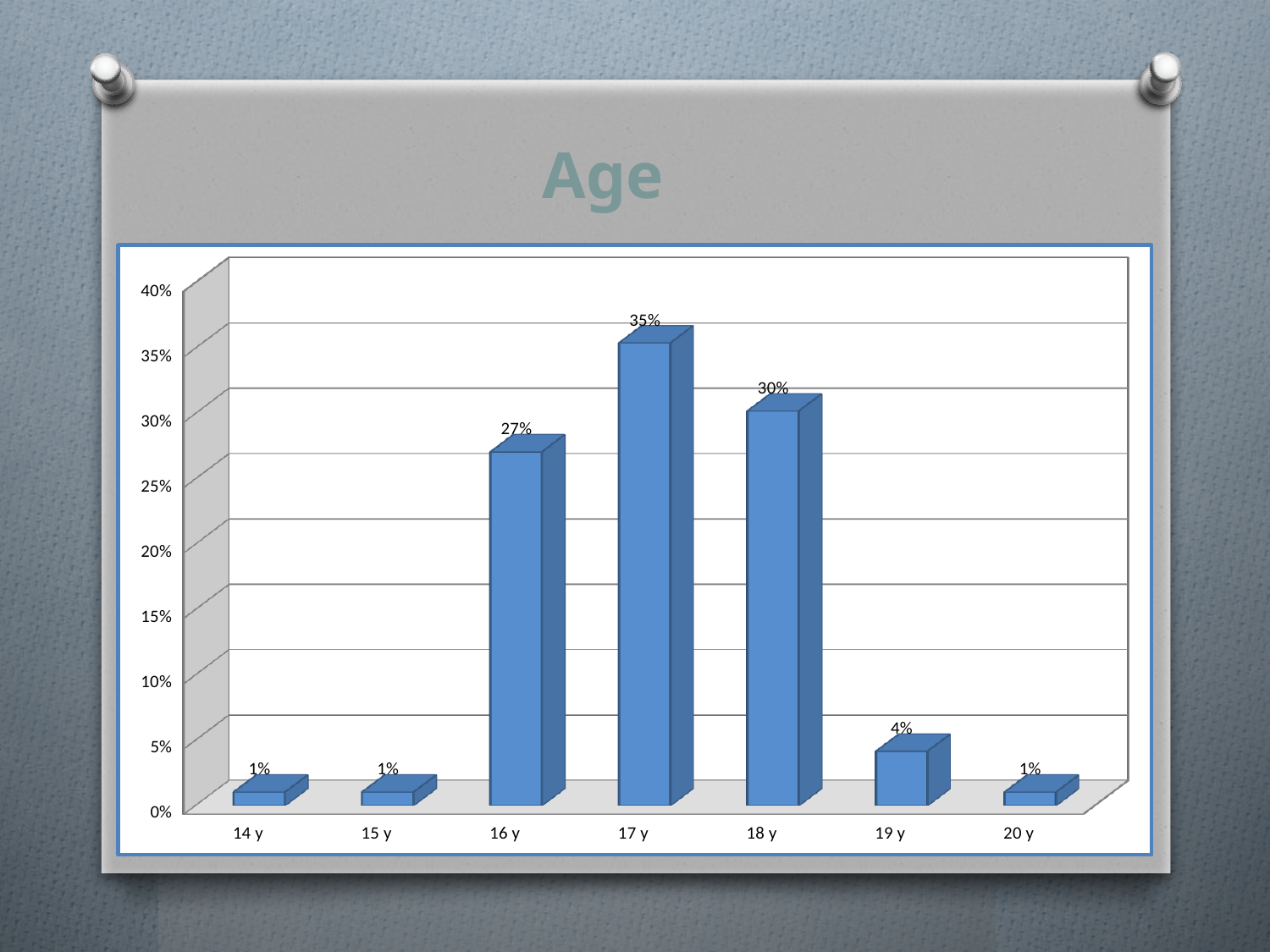
What is the highest value shown on the y axis? 40% What is the title of the slide? Age Is the value for 18 y greater or less than 25%? greater What is the difference between the values for 17 y and 18 y? 5% How many age categories are shown on the x axis? 7 What is the value for 19 y? 4% Which is larger, the value for 16 y or the value for 18 y? 18 y What is the value for 17 y? 35% Which age category has the highest value? 17 y What is the value for 16 y? 27% What is the difference between the values for 16 y and 19 y? 23% What kind of chart is shown on the slide? bar chart